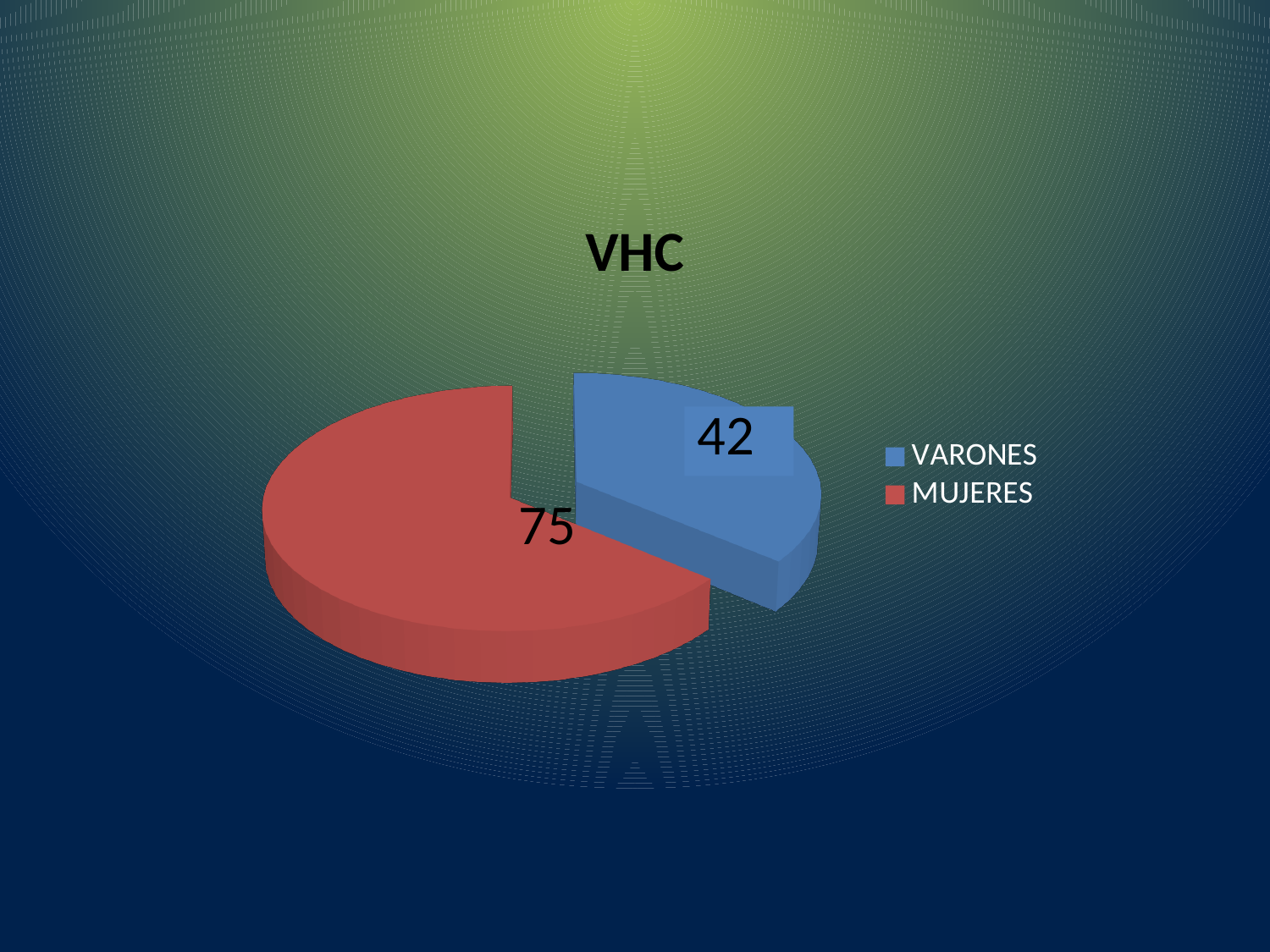
What kind of chart is shown on the slide? Pie chart Which is larger, VARONES or MUJERES? MUJERES How many slices does the pie chart have? 2 What is the value for VARONES? 42 What is the difference between the values for MUJERES and VARONES? 33 Which category has the smallest slice? VARONES What is the title of the chart? VHC Which category has the largest slice? MUJERES What is the total of the two slices? 117 How many entries does the legend list? 2 What colour is the MUJERES slice? Red What is the value for MUJERES? 75